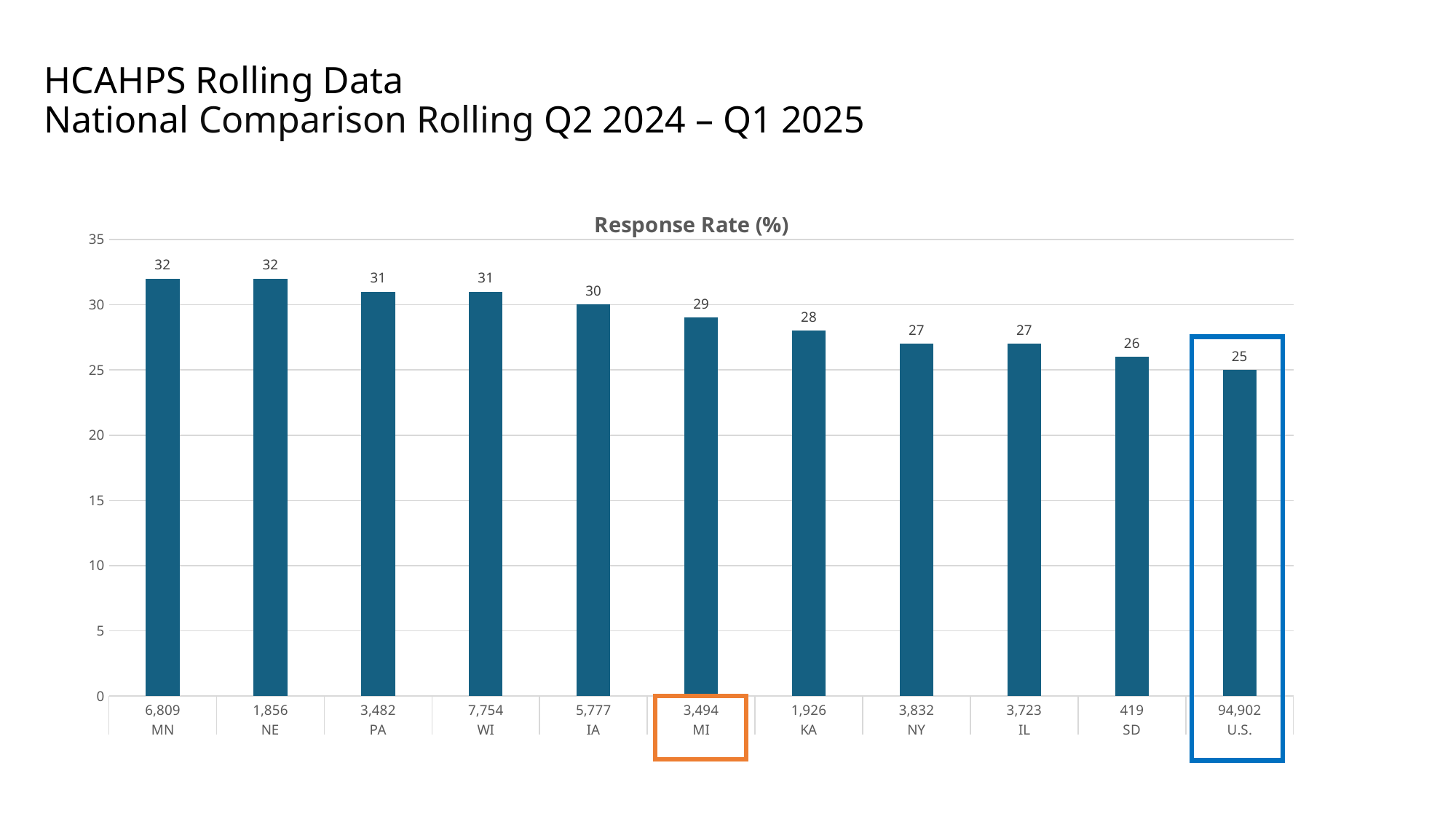
What is the difference between the response rate for MI and the response rate for KA? 1 What kind of chart is shown on the slide? bar chart Do the response rates rise or fall from left to right along the x axis? fall Is the response rate for IA greater or less than 25? greater What is the title of the chart? Response Rate (%) How many categories are shown on the x axis? 11 What is the difference between the response rate for MN and the response rate for U.S.? 7 What is the response rate for SD? 26 Which has a higher response rate, PA or SD? PA What is the response rate for MI? 29 Which category has the lowest response rate? U.S. What is the response rate for U.S.? 25